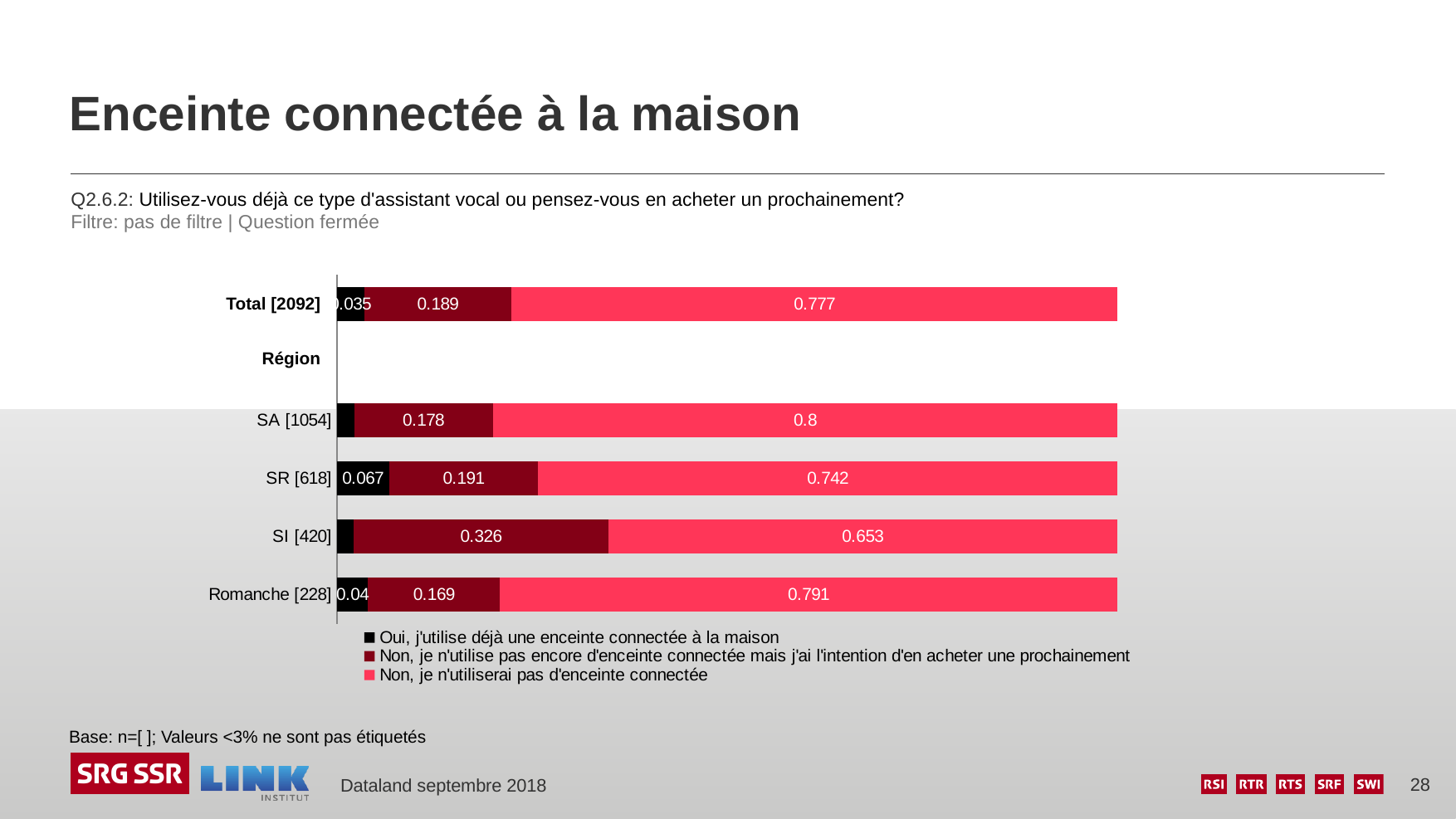
Which region has the highest value for "Non, je n'utiliserai pas d'enceinte connectée"? SA [1054] What is the value for SR [618] in the series "Non, je n'utiliserai pas d'enceinte connectée"? 0.742 Which region has the lowest value for "Non, je n'utiliserai pas d'enceinte connectée"? SI [420] What kind of chart is shown on the slide? Stacked bar chart What is the value for SI [420] in the series "Non, je n'utilise pas encore d'enceinte connectée mais j'ai l'intention d'en acheter une prochainement"? 0.326 How many series does the legend list? 3 What is the value for Romanche [228] in the series "Oui, j'utilise déjà une enceinte connectée à la maison"? 0.04 What is the value for SR [618] in the series "Oui, j'utilise déjà une enceinte connectée à la maison"? 0.067 What is the value for SA [1054] in the series "Non, je n'utiliserai pas d'enceinte connectée"? 0.8 Which region has the highest value for "Non, je n'utilise pas encore d'enceinte connectée mais j'ai l'intention d'en acheter une prochainement"? SI [420] Which is larger for "Non, je n'utiliserai pas d'enceinte connectée": SR [618] or Romanche [228]? Romanche [228] What is the difference between SI [420] and SA [1054] in the series "Non, je n'utilise pas encore d'enceinte connectée mais j'ai l'intention d'en acheter une prochainement"? 0.148